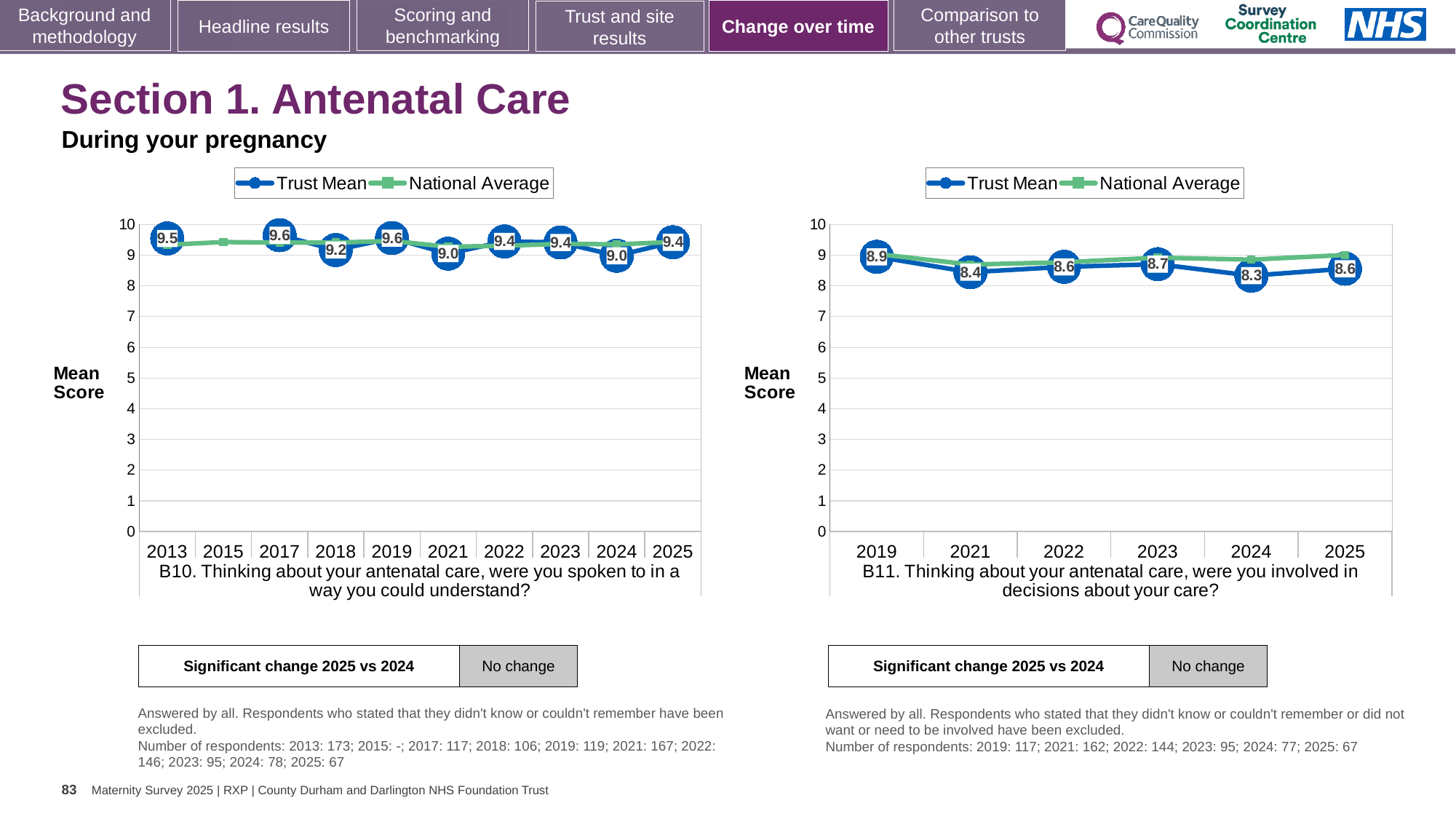
On the B10 chart (left), which year has the larger Trust Mean, 2018 or 2021? 2018 How many series does the legend of the B11 chart (right) list? 2 On the B11 chart (right), what is the difference between the Trust Mean in 2019 and in 2024? 0.6 What kind of chart is the B11 chart (right)? Line chart On the B11 chart (right), which year has the highest Trust Mean? 2019 On the B11 chart (right), which year has the lowest Trust Mean? 2024 On the B11 chart (right), does the Trust Mean rise or fall from 2019 to 2021? Fall On the B10 chart (left), what is the lowest Trust Mean value shown? 9.0 On the B10 chart (left), what is the Trust Mean for 2013? 9.5 How many years are shown on the x axis of the B10 chart (left)? 10 On the B10 chart (left), is the National Average for 2015 greater or less than 9? greater On the B11 chart (right), what is the Trust Mean for 2024? 8.3